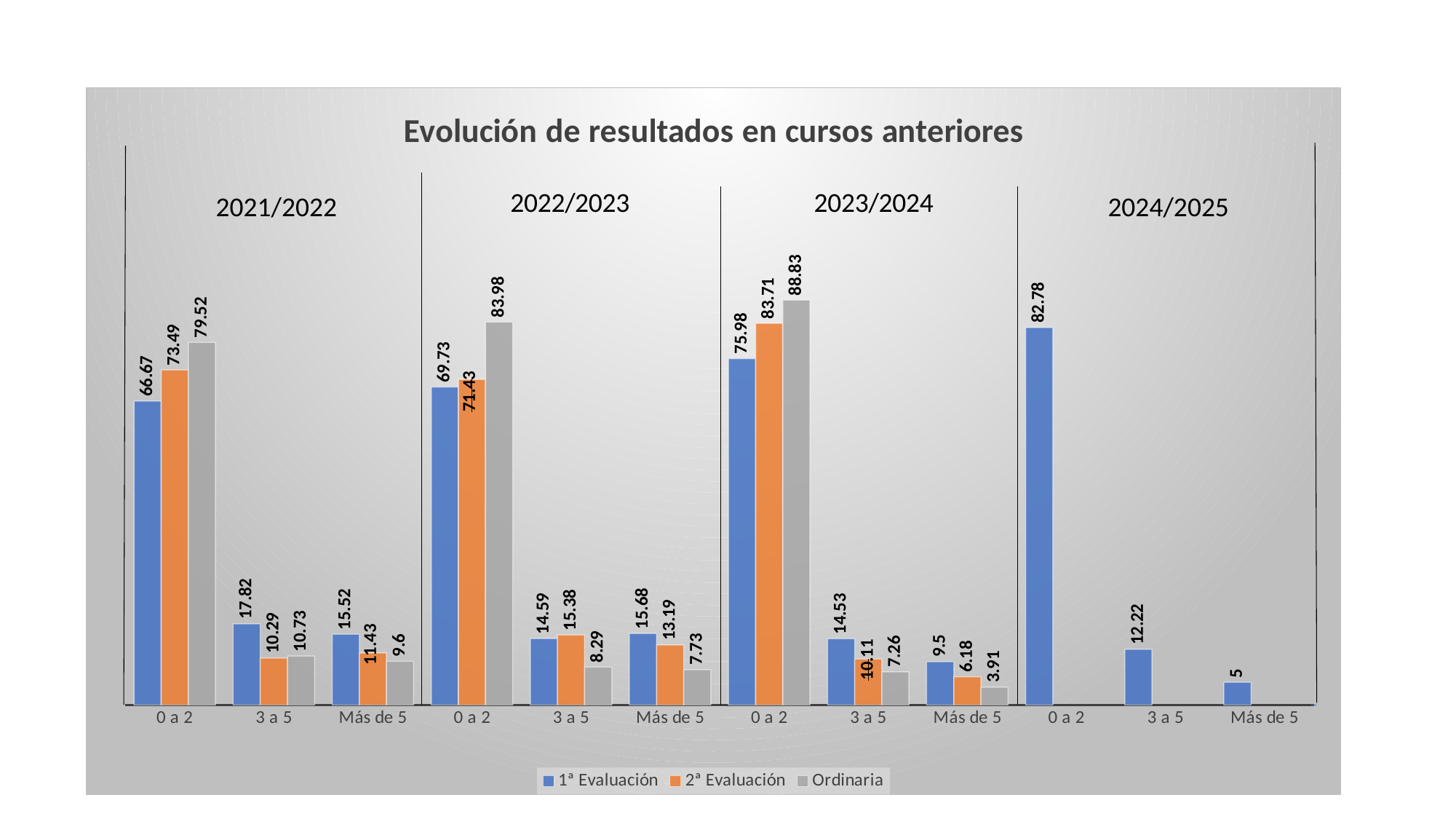
Which bar has the highest value in the whole chart? Ordinaria, 0 a 2, 2023/2024 (88.83) What is the title of the chart? Evolución de resultados en cursos anteriores What is the value of Ordinaria for '0 a 2' in 2021/2022? 79.52 Which bar has the lowest value in the whole chart? Ordinaria, Más de 5, 2023/2024 (3.91) How many series does the legend list? 3 What is the difference between the Ordinaria and 1ª Evaluación values for '0 a 2' in 2022/2023? 14.25 How many school years are shown on the x axis? 4 What kind of chart is shown on the slide? Bar chart What is the value of 2ª Evaluación for 'Más de 5' in 2023/2024? 6.18 What is the value of 1ª Evaluación for '0 a 2' in 2024/2025? 82.78 Which is larger for '3 a 5' in 2022/2023: 1ª Evaluación or 2ª Evaluación? 2ª Evaluación What is the value of 1ª Evaluación for '3 a 5' in 2022/2023? 14.59